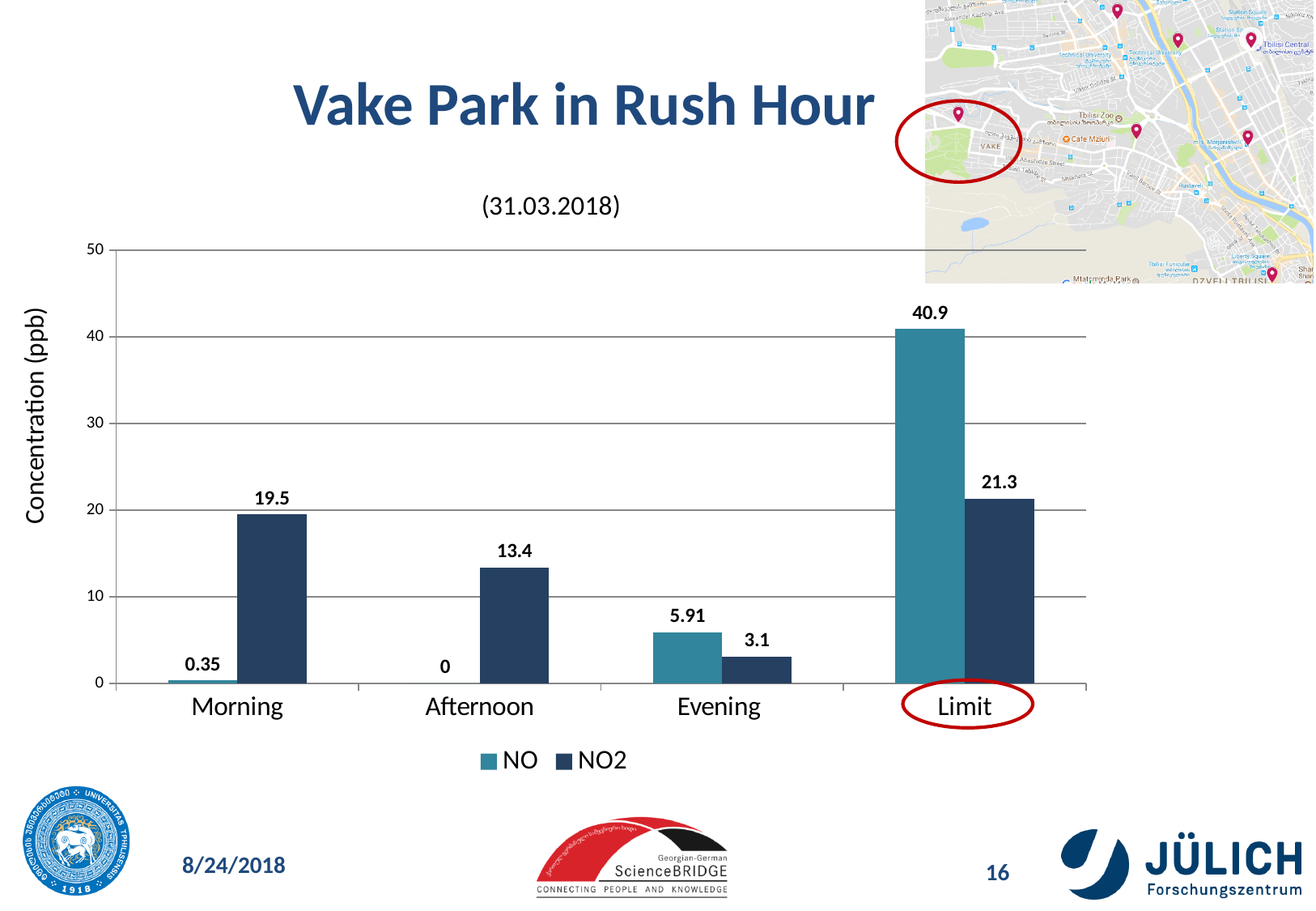
Among Morning, Afternoon and Evening, which has the lowest NO2 value? Evening What is the NO concentration in the Evening? 5.91 What is the NO concentration in the Afternoon? 0 How many series does the legend list? 2 What is the NO value shown for the Limit category? 40.9 Which category has the highest NO2 value? Limit What is the difference between the NO2 values for Morning and Afternoon? 6.1 Is the NO value for Limit greater or less than 40? greater What is the NO2 concentration in the Morning? 19.5 What type of chart is shown on the slide? Bar chart How many categories are shown on the x axis? 4 Which is larger in the Evening, the NO value or the NO2 value? NO